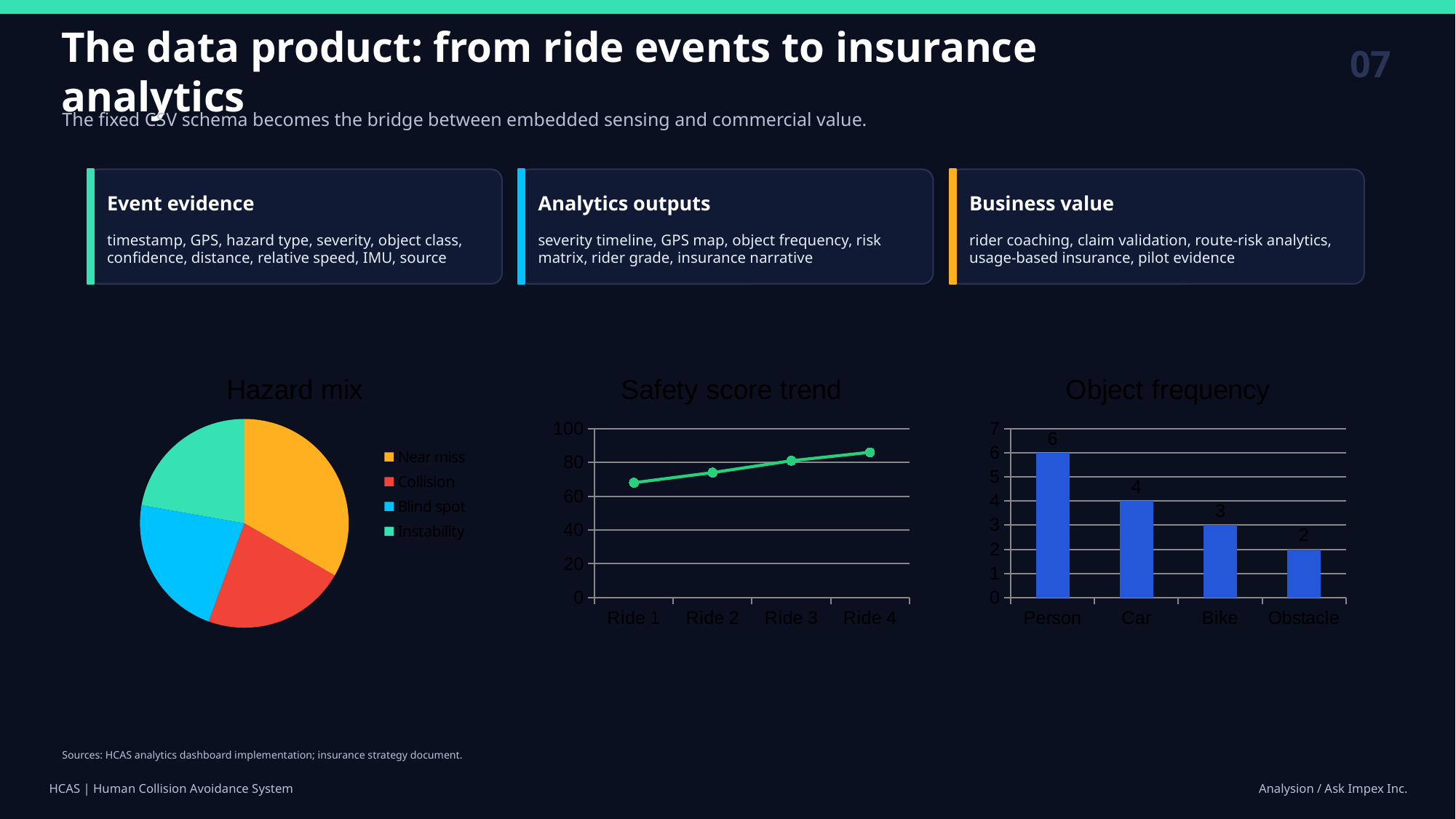
In the 'Object frequency' chart, what is the value for Obstacle? 2 What kind of chart is the 'Object frequency' chart? Bar chart How many entries does the legend of the 'Hazard mix' chart list? 4 In the 'Object frequency' chart, which category has the lowest value? Obstacle In the 'Hazard mix' chart, which slice is the largest? Near miss In the 'Object frequency' chart, what is the difference between the values for Car and Bike? 1 In the 'Safety score trend' chart, is the value for Ride 1 greater or less than 60? greater In the 'Safety score trend' chart, is the value for Ride 4 greater or less than 80? greater In the 'Safety score trend' chart, do the values rise or fall from Ride 1 to Ride 4? Rise In the 'Object frequency' chart, what is the value for Person? 6 In the 'Object frequency' chart, how many categories are shown on the x axis? 4 In the 'Object frequency' chart, which category has the highest value? Person